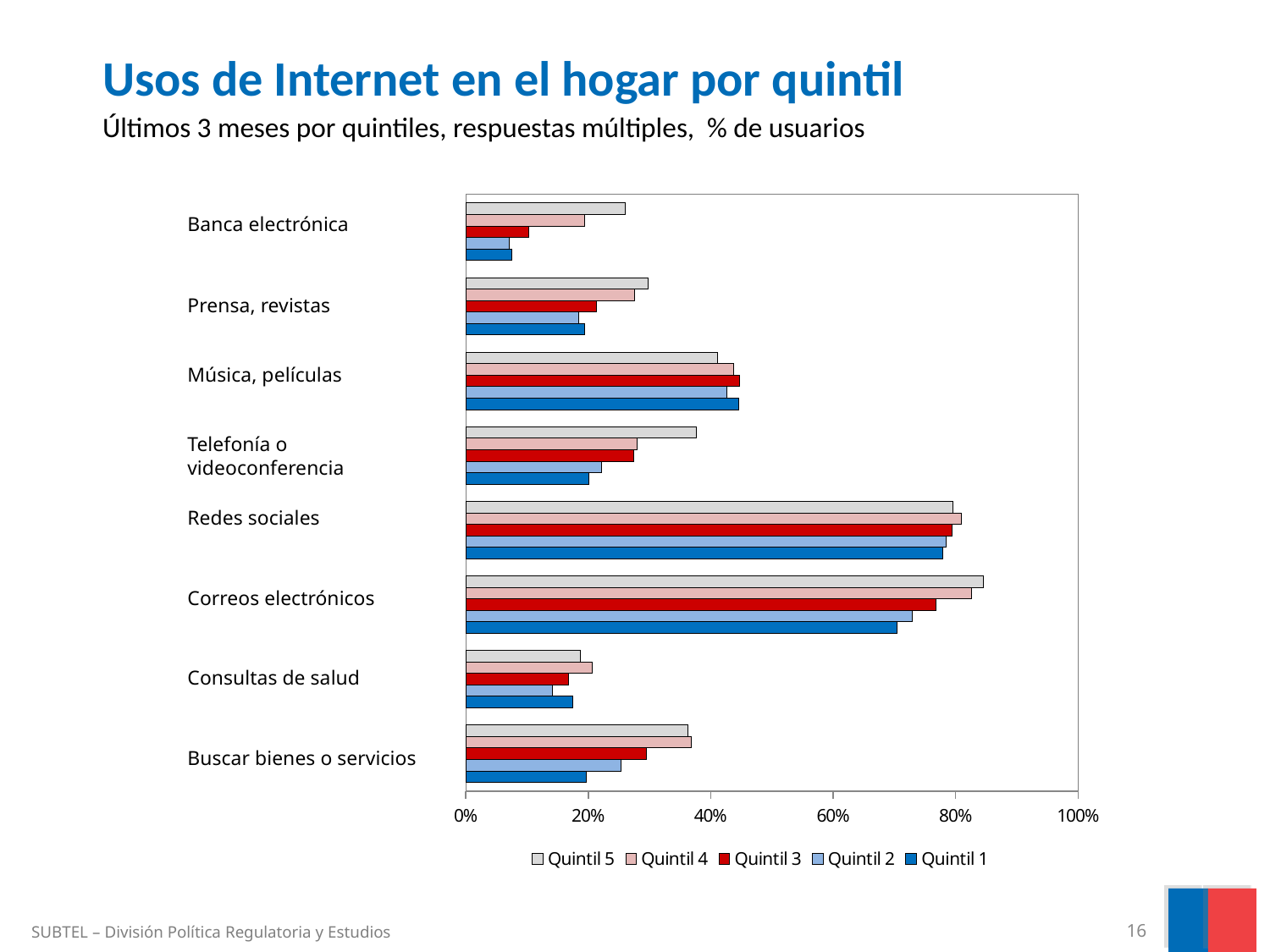
Which category has the lowest value for Quintil 1? Banca electrónica In Correos electrónicos, which is larger: the value for Quintil 1 or for Quintil 5? Quintil 5 How many categories (Internet uses) are shown on the chart? 8 Which category has the highest value for Quintil 5? Correos electrónicos Is the value for Quintil 1 in Banca electrónica greater or less than 20%? less How many series does the legend list? 5 What kind of chart is shown on the slide? bar chart What is the title of the chart on the slide? Usos de Internet en el hogar por quintil Is the value for Quintil 3 in Música, películas greater or less than 40%? greater Is the value for Quintil 4 in Consultas de salud greater or less than 40%? less In Banca electrónica, which is larger: the value for Quintil 5 or for Quintil 1? Quintil 5